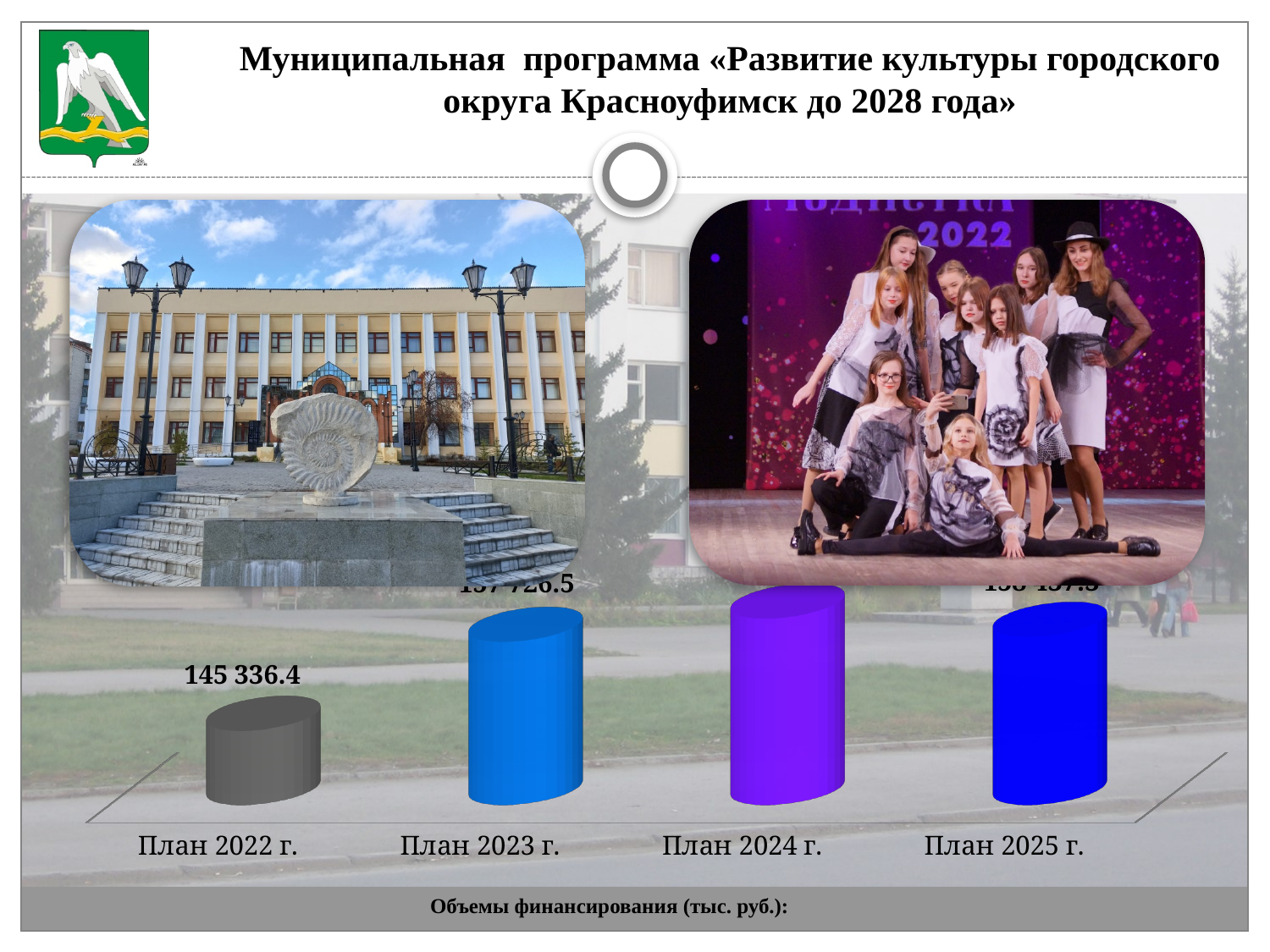
What colour is the bar for План 2022 г.? grey Which is larger, the value for План 2022 г. or the value for План 2023 г.? План 2023 г. Which is larger, the value for План 2022 г. or the value for План 2025 г.? План 2025 г. What kind of chart is shown on the slide? bar chart What unit of measurement is given for the financing volumes in the chart caption? тыс. руб. Which category has the lowest value in the chart? План 2022 г. Does the value rise or fall from План 2022 г. to План 2023 г.? rise How many categories are plotted in the chart? 4 What is the value shown for План 2022 г.? 145 336.4